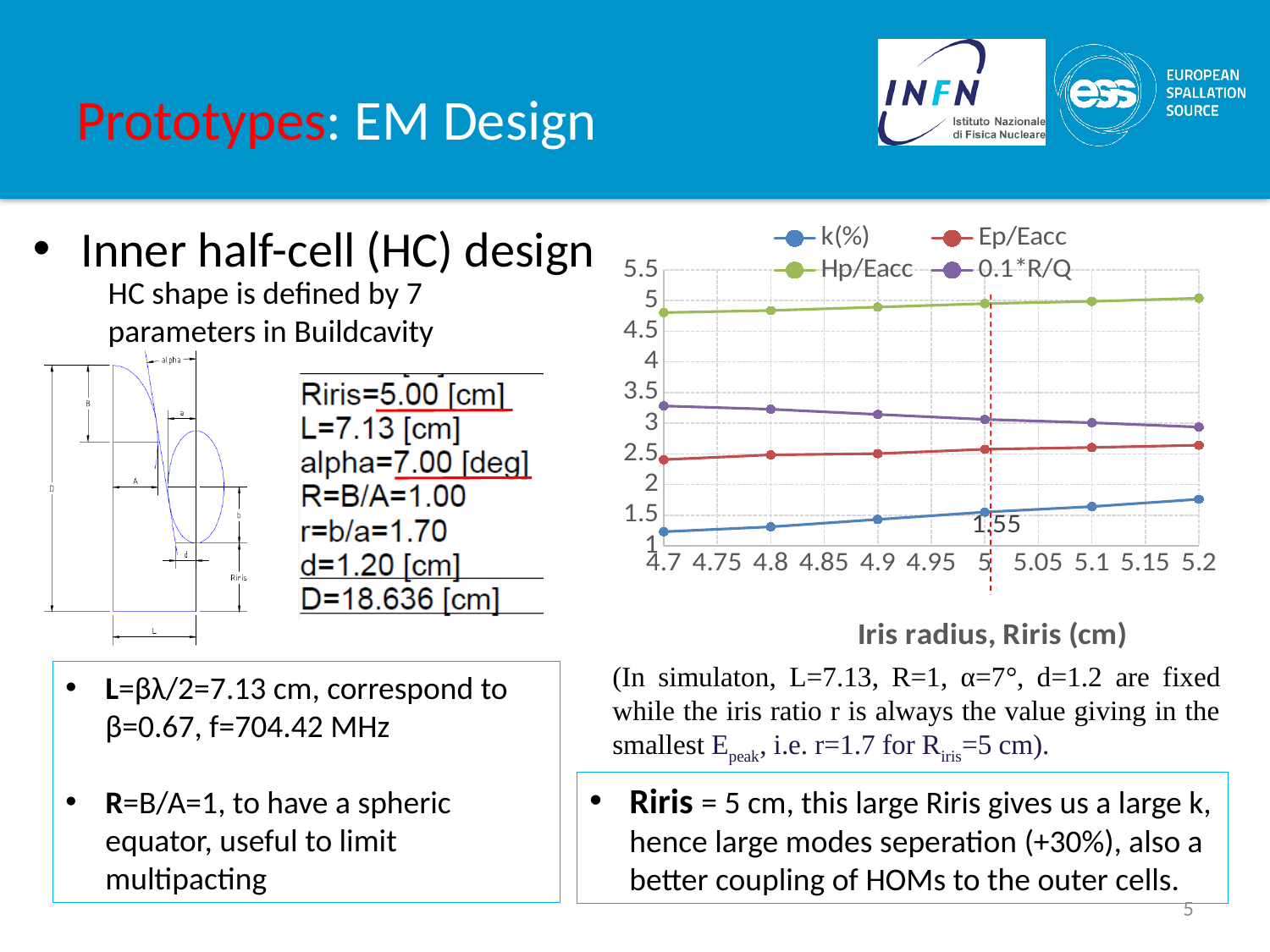
How many data points are plotted for the k(%) series? 6 Does the k(%) series rise or fall as the iris radius increases from 4.7 to 5.2 cm? rise How many series does the chart legend list? 4 What is the value of k(%) at an iris radius of 5 cm? 1.55 Is the value of 0.1*R/Q at an iris radius of 4.7 cm greater or less than 3? greater At an iris radius of 4.7 cm, which is larger: Hp/Eacc or Ep/Eacc? Hp/Eacc Which series has the highest values across the whole chart? Hp/Eacc Does the 0.1*R/Q series rise or fall as the iris radius increases? fall Is the value of Hp/Eacc at an iris radius of 4.7 cm greater or less than 4.5? greater Which series has the lowest values across the whole chart? k(%) What is the title of the x axis of the chart? Iris radius, Riris (cm) What kind of chart is shown on the slide? line chart